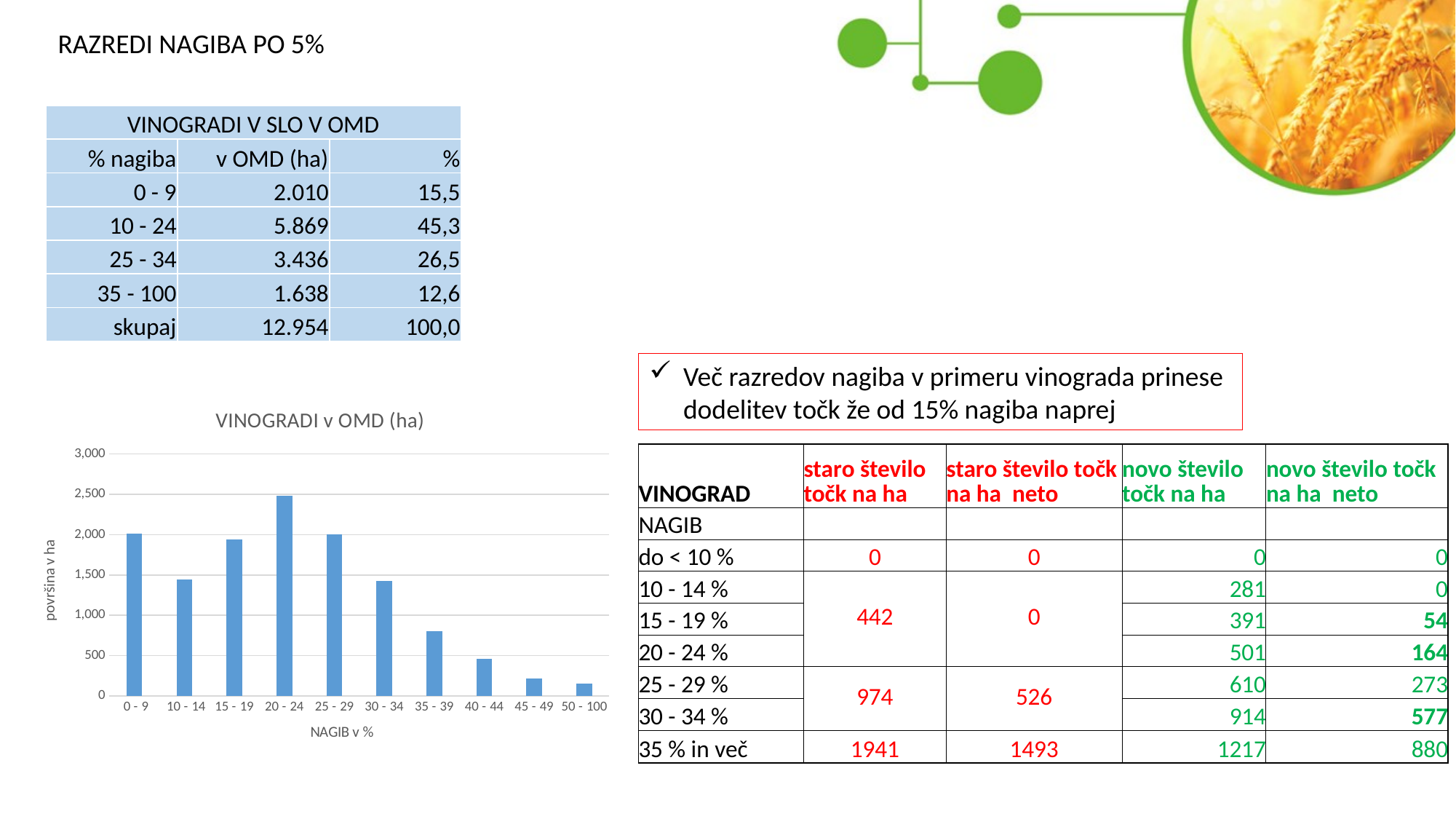
In the 'VINOGRADI v OMD (ha)' chart, is the value for 35 - 39 greater or less than 1,000? less In the 'VINOGRADI v OMD (ha)' chart, is the value for 15 - 19 greater or less than 1,500? greater In the 'VINOGRADI v OMD (ha)' chart, is the value for 20 - 24 greater or less than 2,000? greater In the 'VINOGRADI v OMD (ha)' chart, which is larger, the value for 0 - 9 or the value for 10 - 14? 0 - 9 In the 'VINOGRADI v OMD (ha)' chart, do the values rise or fall from the 20 - 24 class to the 50 - 100 class? fall In the 'VINOGRADI v OMD (ha)' chart, which slope class (NAGIB v %) has the highest value? 20 - 24 What kind of chart is the 'VINOGRADI v OMD (ha)' chart? bar chart What is the label of the vertical axis in the 'VINOGRADI v OMD (ha)' chart? površina v ha In the 'VINOGRADI v OMD (ha)' chart, which is larger, the value for 25 - 29 or the value for 30 - 34? 25 - 29 How many slope classes are shown on the x axis of the 'VINOGRADI v OMD (ha)' chart? 10 In the 'VINOGRADI v OMD (ha)' chart, which slope class has the lowest value? 50 - 100